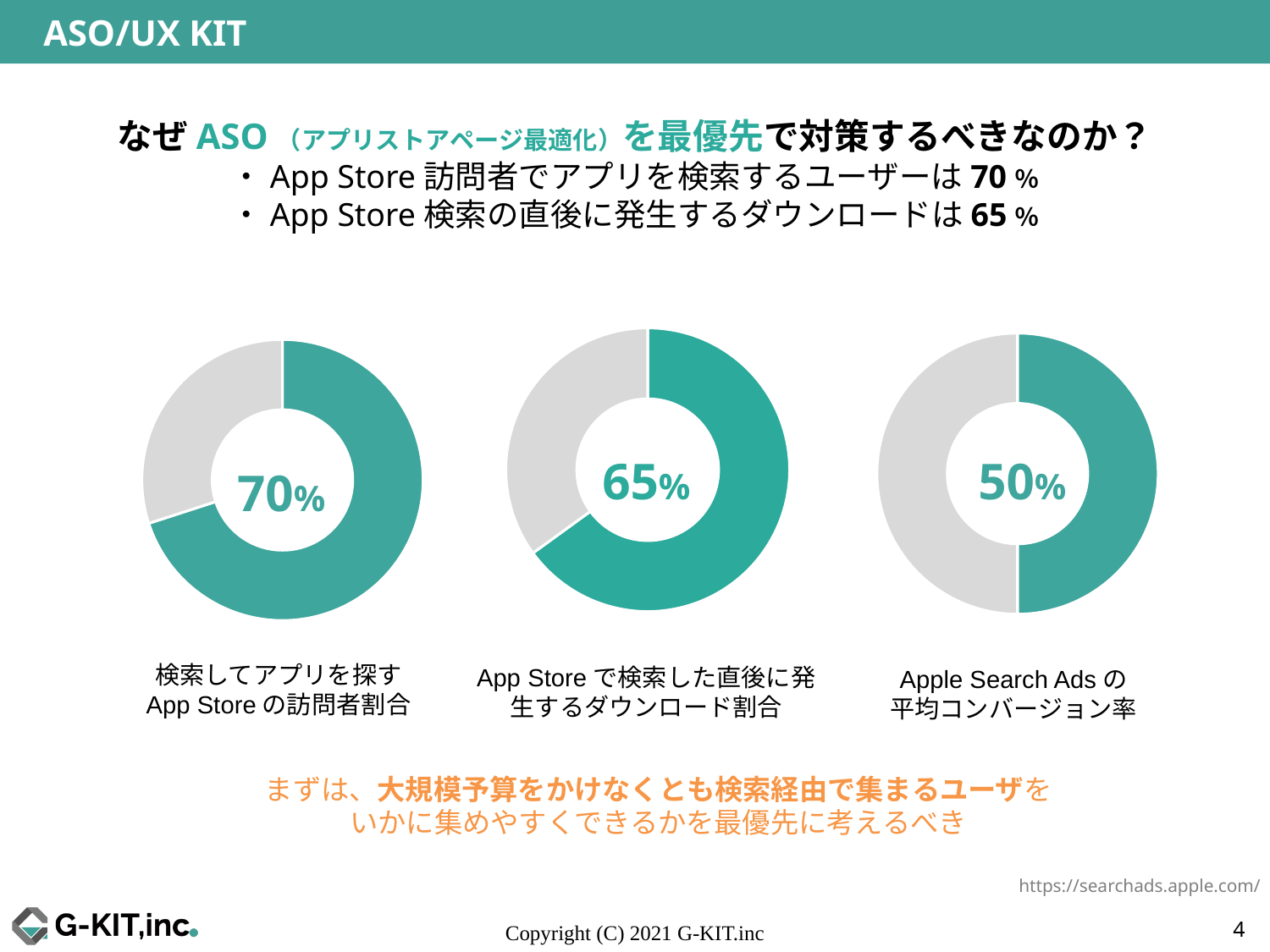
Which is larger: the value in the middle donut chart or the value in the right donut chart? The middle donut chart (65%) Which of the three donut charts shows the lowest percentage? Apple Search Ads の平均コンバージョン率 (50%) What is the difference between the value in the left donut chart and the value in the middle donut chart? 5% In the middle donut chart (App Store で検索した直後に発生するダウンロード割合), what value is shown in the centre? 65% In the right donut chart, what share of the ring is filled with the teal colour? 50% What kind of chart is used for the three figures on the slide? Donut (pie) chart Which of the three donut charts shows the highest percentage? 検索してアプリを探す App Store の訪問者割合 (70%) What colour is used for the highlighted (filled) portion of each donut chart? Teal (green) How many donut charts are shown on the slide? 3 What is the difference between the value in the left donut chart and the value in the right donut chart? 20% In the left donut chart (検索してアプリを探す App Store の訪問者割合), what value is shown in the centre? 70% In the right donut chart (Apple Search Ads の平均コンバージョン率), what value is shown in the centre? 50%